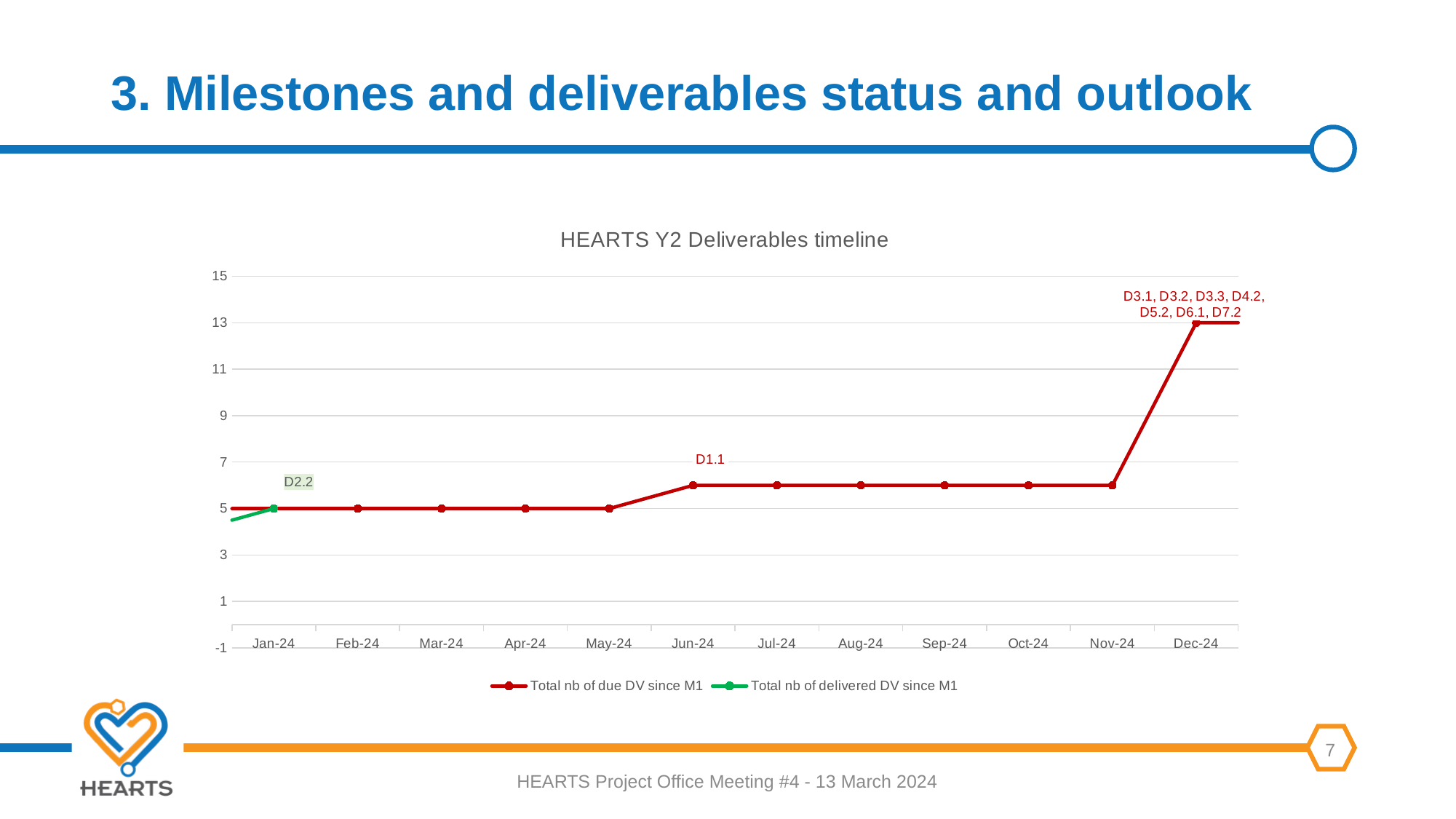
Is the value for 'Total nb of due DV since M1' in Nov-24 greater or less than 7? less What is the value of 'Total nb of due DV since M1' in Jan-24? 5 What is the title of the chart? HEARTS Y2 Deliverables timeline Which deliverable label is attached to the Jun-24 point of the red line? D1.1 Does 'Total nb of due DV since M1' rise or fall from Jan-24 to Dec-24? rise What is the difference between 'Total nb of due DV since M1' in Dec-24 and in Jan-24? 8 How many months are shown on the x axis? 12 Is the value for 'Total nb of due DV since M1' in Jun-24 greater or less than 5? greater In which month is 'Total nb of due DV since M1' highest? Dec-24 What type of chart is shown on the slide? line chart What is the value of 'Total nb of due DV since M1' in Dec-24? 13 How many series does the legend list? 2